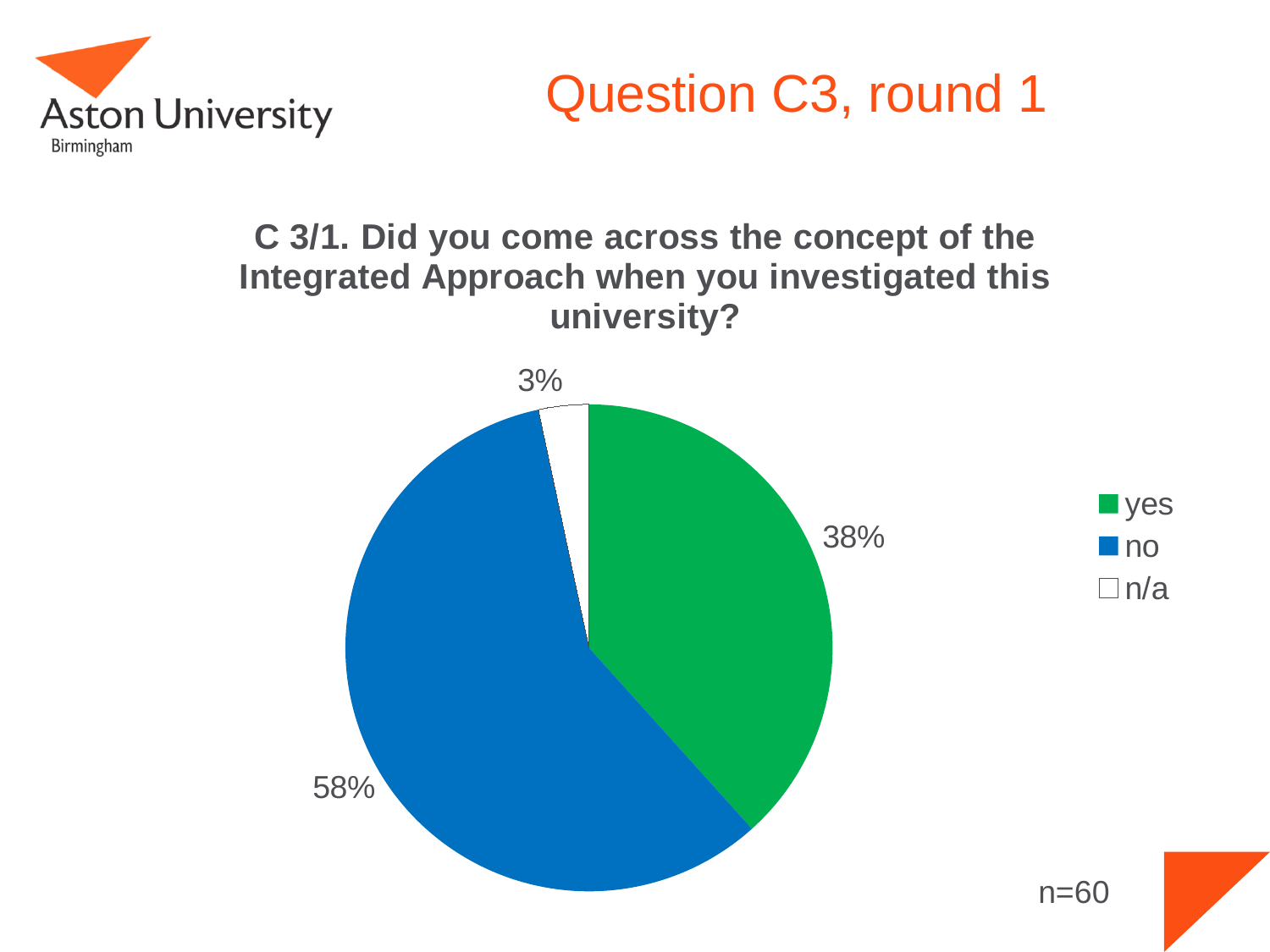
Which response has the smallest share of the pie? n/a What percentage of respondents answered "yes"? 38% Which is larger, the share for "yes" or the share for "no"? no What is the difference in percentage points between the "no" and "yes" shares? 20 How many entries does the legend list? 3 What colour is the "no" slice? blue What kind of chart is shown on the slide? pie chart Which response has the largest share of the pie? no What percentage of respondents answered "no"? 58% What is the sample size (n) shown on the slide? n=60 How many slices does the pie chart have? 3 What percentage of respondents answered "n/a"? 3%